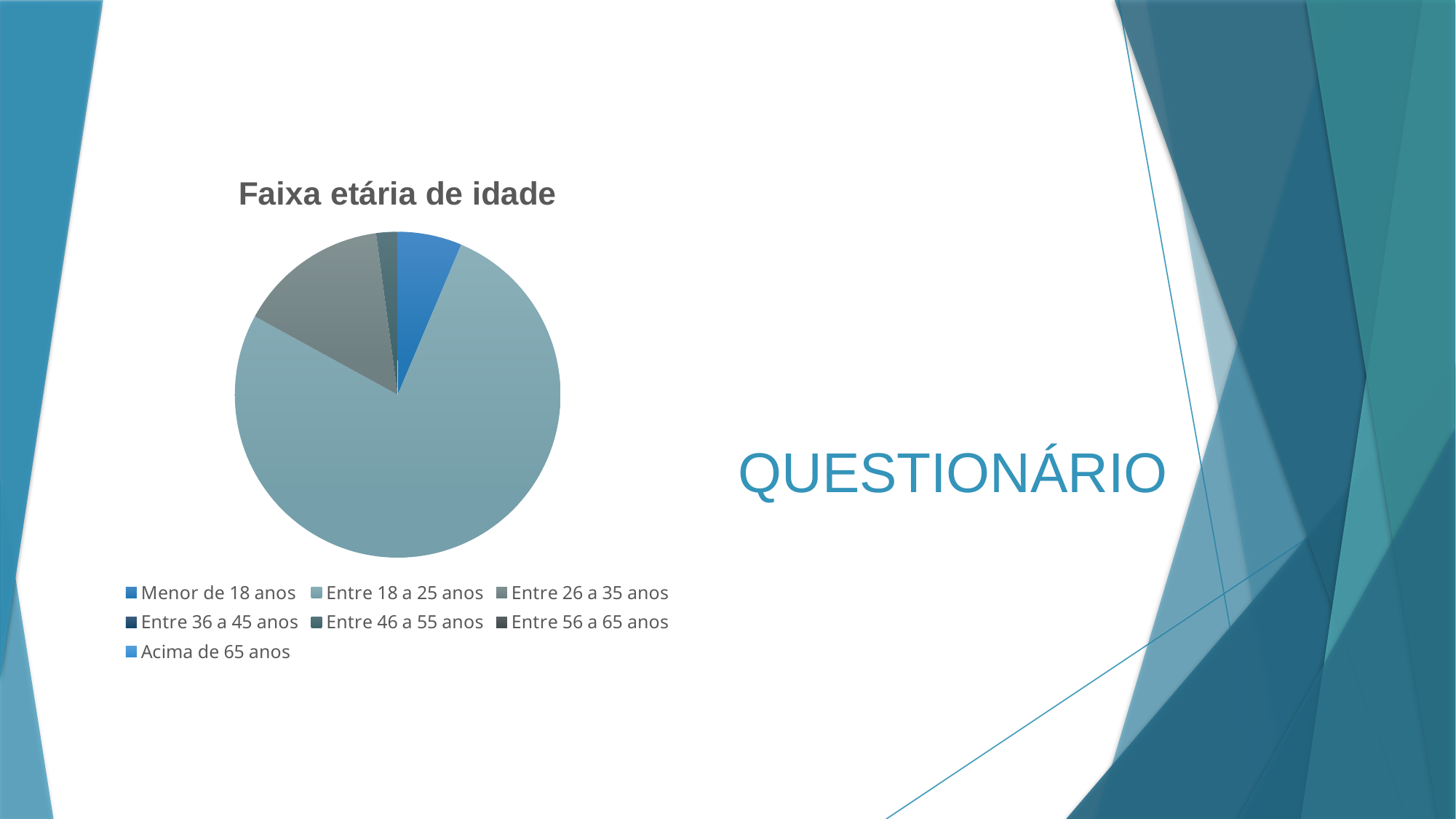
Which legend entry is listed first in the chart's legend? Menor de 18 anos Which slice is larger: Entre 26 a 35 anos or Menor de 18 anos? Entre 26 a 35 anos What kind of chart is shown on the slide? Pie chart Which slice is larger: Entre 18 a 25 anos or Menor de 18 anos? Entre 18 a 25 anos Does the Entre 18 a 25 anos slice take up more or less than half of the pie? more Which slice is larger: Entre 18 a 25 anos or Entre 26 a 35 anos? Entre 18 a 25 anos Which age group has the largest slice of the pie? Entre 18 a 25 anos What is the title of the chart? Faixa etária de idade How many categories does the chart's legend list? 7